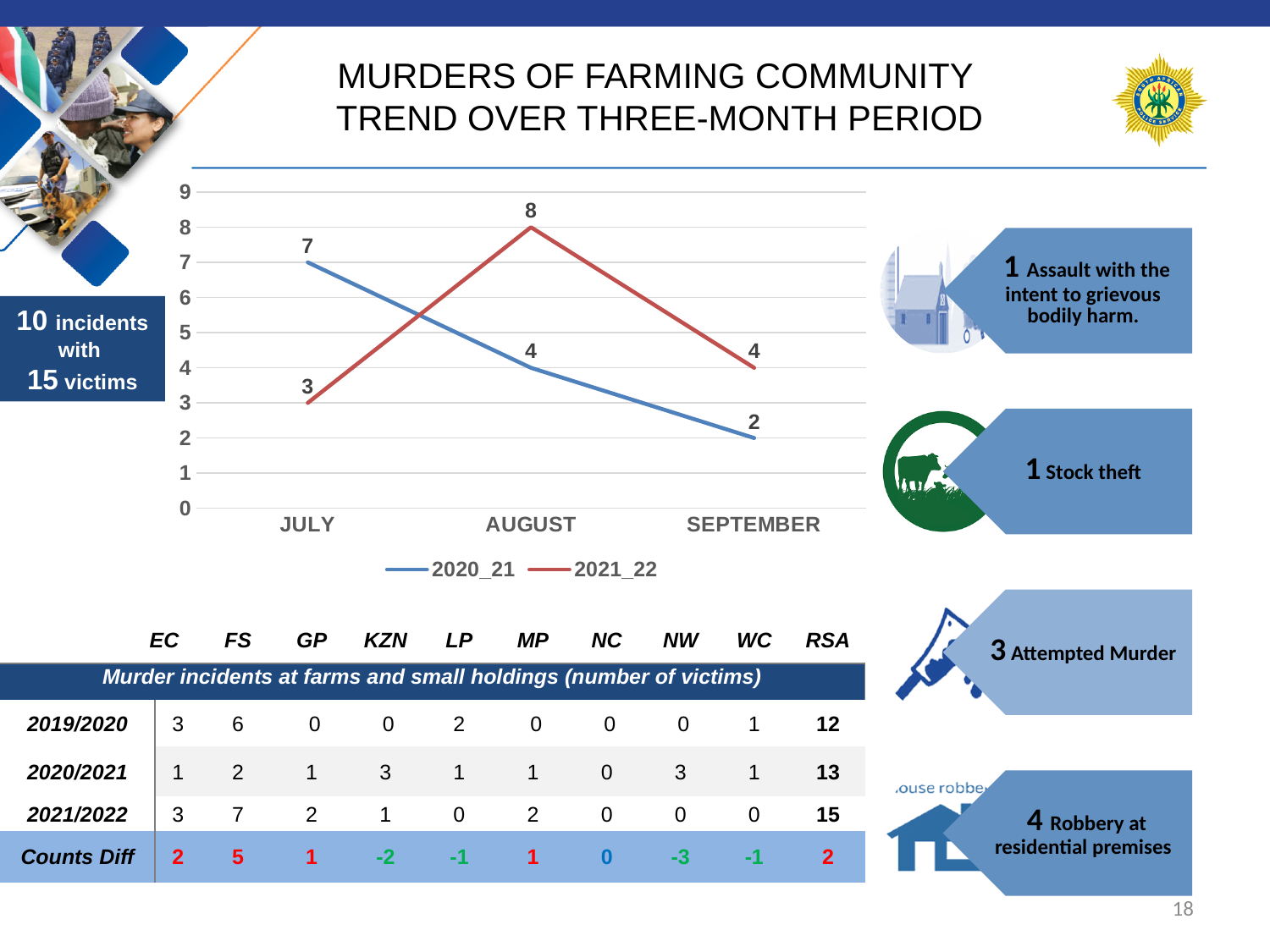
In which month does the 2021_22 series reach its highest value? August What is the value for 2020_21 in September? 2 What is the value for 2021_22 in August? 8 Which series has the larger value in September, 2020_21 or 2021_22? 2021_22 What is the value for 2020_21 in July? 7 How many months are plotted along the x axis of the chart? 3 What type of chart is shown on the slide? line chart In which month is the 2020_21 series lowest? September Does the 2020_21 series rise or fall from July to September? fall How many series does the chart legend list? 2 What is the difference between the 2021_22 and 2020_21 values in August? 4 What is the value for 2021_22 in July? 3